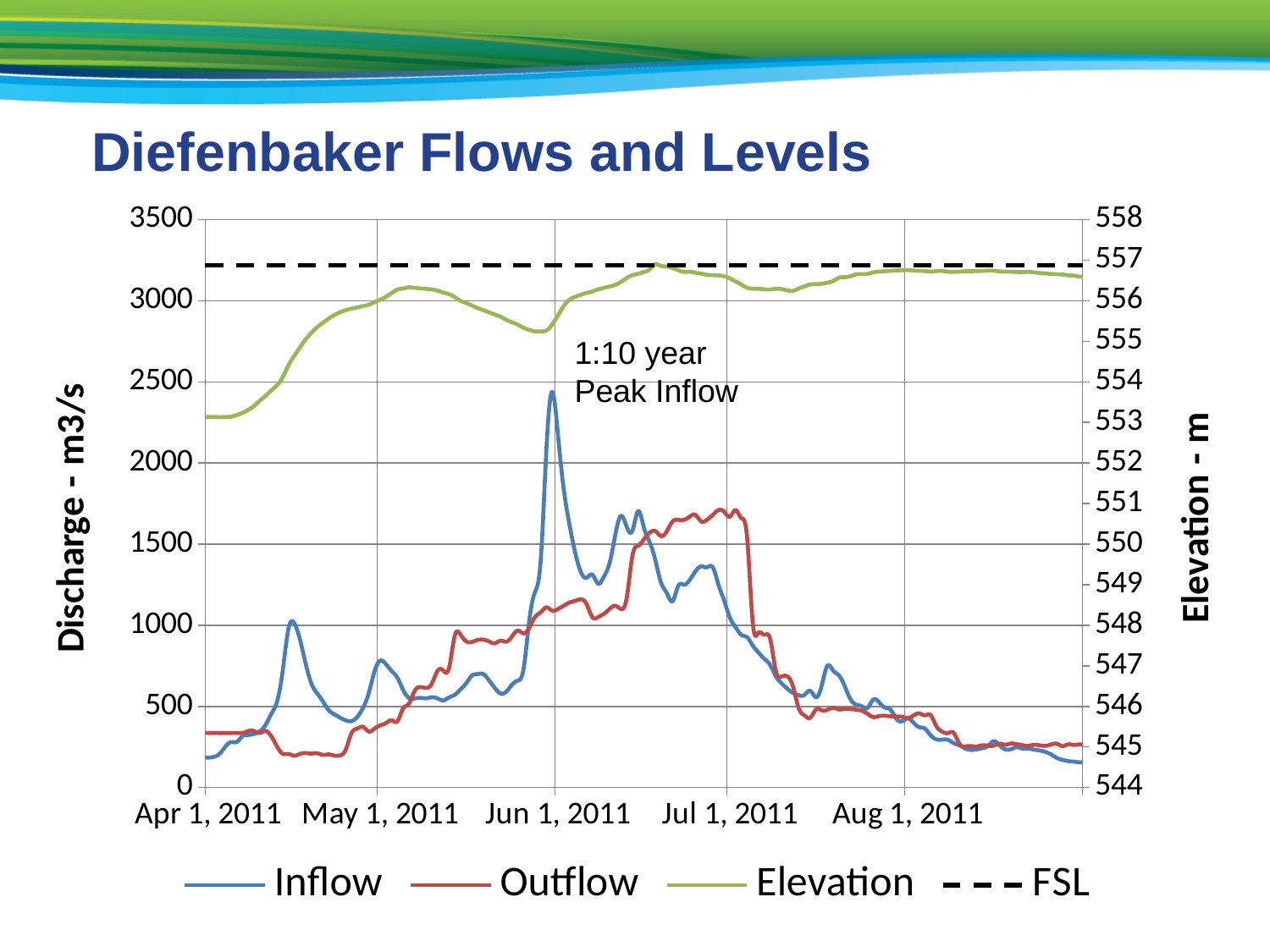
What kind of chart is shown on the slide? line chart Is the peak value of the Outflow series greater or less than 2000? less Which series reaches the higher peak discharge, Inflow or Outflow? Inflow Is the peak value of the Inflow series greater or less than 2000? greater What is the label of the right-hand vertical axis? Elevation - m Is the Elevation value on Apr 1, 2011 greater or less than 554? less Does the Elevation series rise or fall between Apr 1, 2011 and Jun 1, 2011? rise Does the Inflow series rise or fall between Jul 1, 2011 and Aug 1, 2011? fall How many series does the legend list? 4 What is the title of the slide's chart? Diefenbaker Flows and Levels